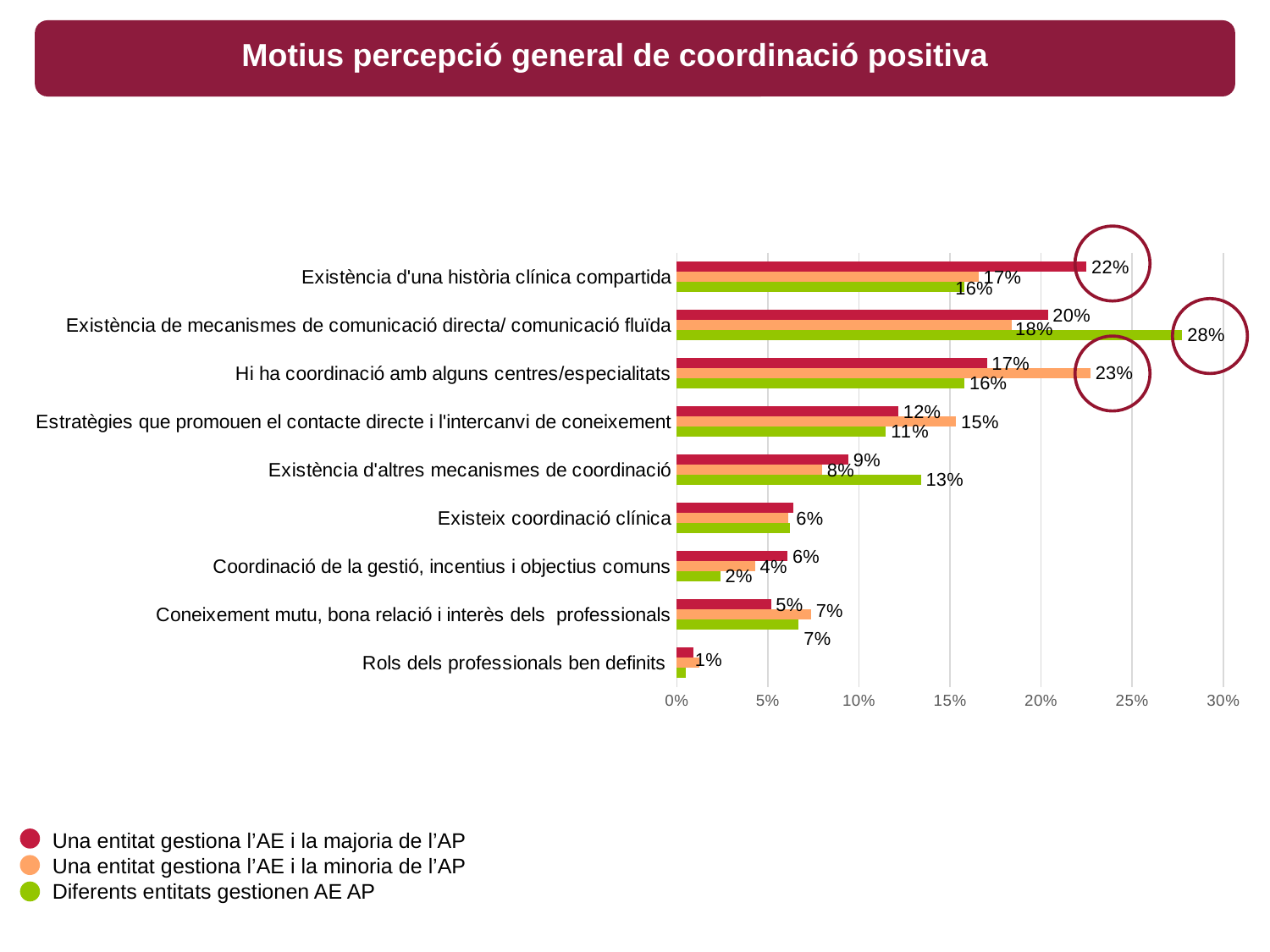
What is the value for 'Diferents entitats gestionen AE AP' in the category 'Existència de mecanismes de comunicació directa/ comunicació fluïda'? 28% Which category has the highest value for 'Diferents entitats gestionen AE AP'? Existència de mecanismes de comunicació directa/ comunicació fluïda What is the value for 'Diferents entitats gestionen AE AP' in the category 'Existència d'altres mecanismes de coordinació'? 13% In the category 'Estratègies que promouen el contacte directe i l'intercanvi de coneixement', which series has the larger value: 'Una entitat gestiona l'AE i la majoria de l'AP' or 'Una entitat gestiona l'AE i la minoria de l'AP'? Una entitat gestiona l'AE i la minoria de l'AP What is the value for 'Una entitat gestiona l'AE i la minoria de l'AP' in the category 'Hi ha coordinació amb alguns centres/especialitats'? 23% Is the value for 'Diferents entitats gestionen AE AP' in the category 'Existeix coordinació clínica' greater or less than 10%? less How many series does the legend list? 3 What kind of chart is shown on the slide? Bar chart How many categories are shown on the chart? 9 In the category 'Existència de mecanismes de comunicació directa/ comunicació fluïda', what is the difference between the value for 'Diferents entitats gestionen AE AP' and the value for 'Una entitat gestiona l'AE i la majoria de l'AP'? 8 percentage points What is the value for 'Una entitat gestiona l'AE i la majoria de l'AP' in the category 'Existència d'una història clínica compartida'? 22% In the category 'Hi ha coordinació amb alguns centres/especialitats', what is the difference between the value for 'Una entitat gestiona l'AE i la minoria de l'AP' and the value for 'Diferents entitats gestionen AE AP'? 7 percentage points